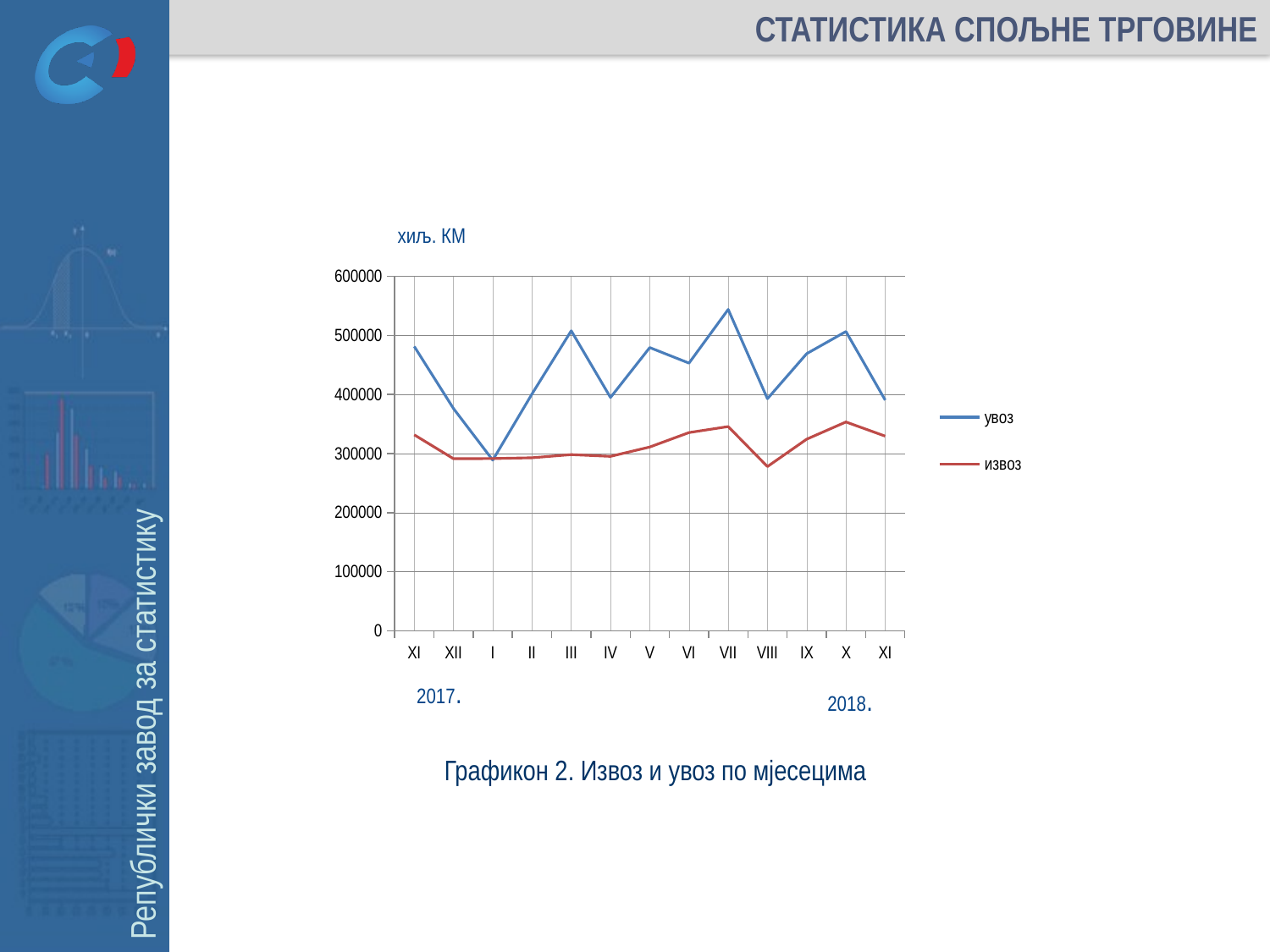
Is the value of извоз in month X greater or less than 300000? greater What unit label is shown above the y axis of the chart? хиљ. КМ How many series does the legend list? 2 Is the value of увоз in month XI of 2017 greater or less than 400000? greater In which month does the увоз series reach its lowest value? I Is the value of увоз in month VII greater or less than 500000? greater What kind of chart is shown on the slide? line chart In which month does the увоз series reach its highest value? VII In month VII, which series has the larger value, увоз or извоз? увоз How many months (points) are plotted along the x axis? 13 Does the увоз series rise or fall from month XI of 2017 to month I of 2018? fall